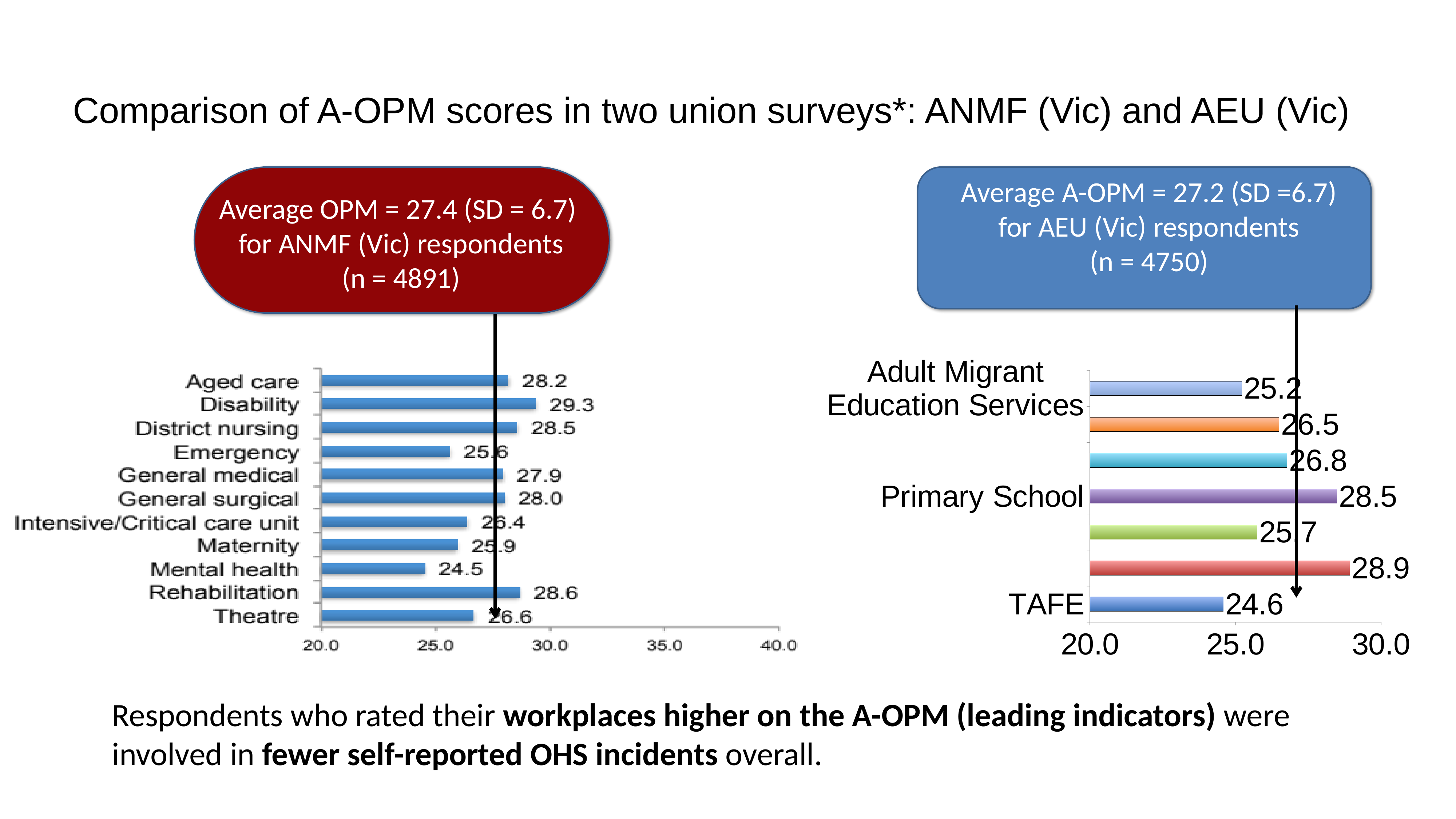
In the left chart (ANMF Vic), what is the A-OPM score for Disability? 29.3 What type of chart is used on the right side of the slide (AEU Vic)? Bar chart In the left chart (ANMF Vic), what is the A-OPM score for Mental health? 24.5 In the right chart (AEU Vic), what is the A-OPM score for Primary School? 28.5 In the left chart (ANMF Vic), which category has the lowest A-OPM score? Mental health In the right chart (AEU Vic), which of the labelled categories has the lowest score? TAFE How many categories are shown in the left chart (ANMF Vic)? 11 In the left chart (ANMF Vic), what is the difference between the scores for Rehabilitation and Theatre? 2.0 In the left chart (ANMF Vic), which category has the highest A-OPM score? Disability In the right chart (AEU Vic), what is the difference between the scores for Primary School and Adult Migrant Education Services? 3.3 In the right chart (AEU Vic), what is the A-OPM score for TAFE? 24.6 In the left chart (ANMF Vic), which has a higher score, Aged care or Emergency? Aged care